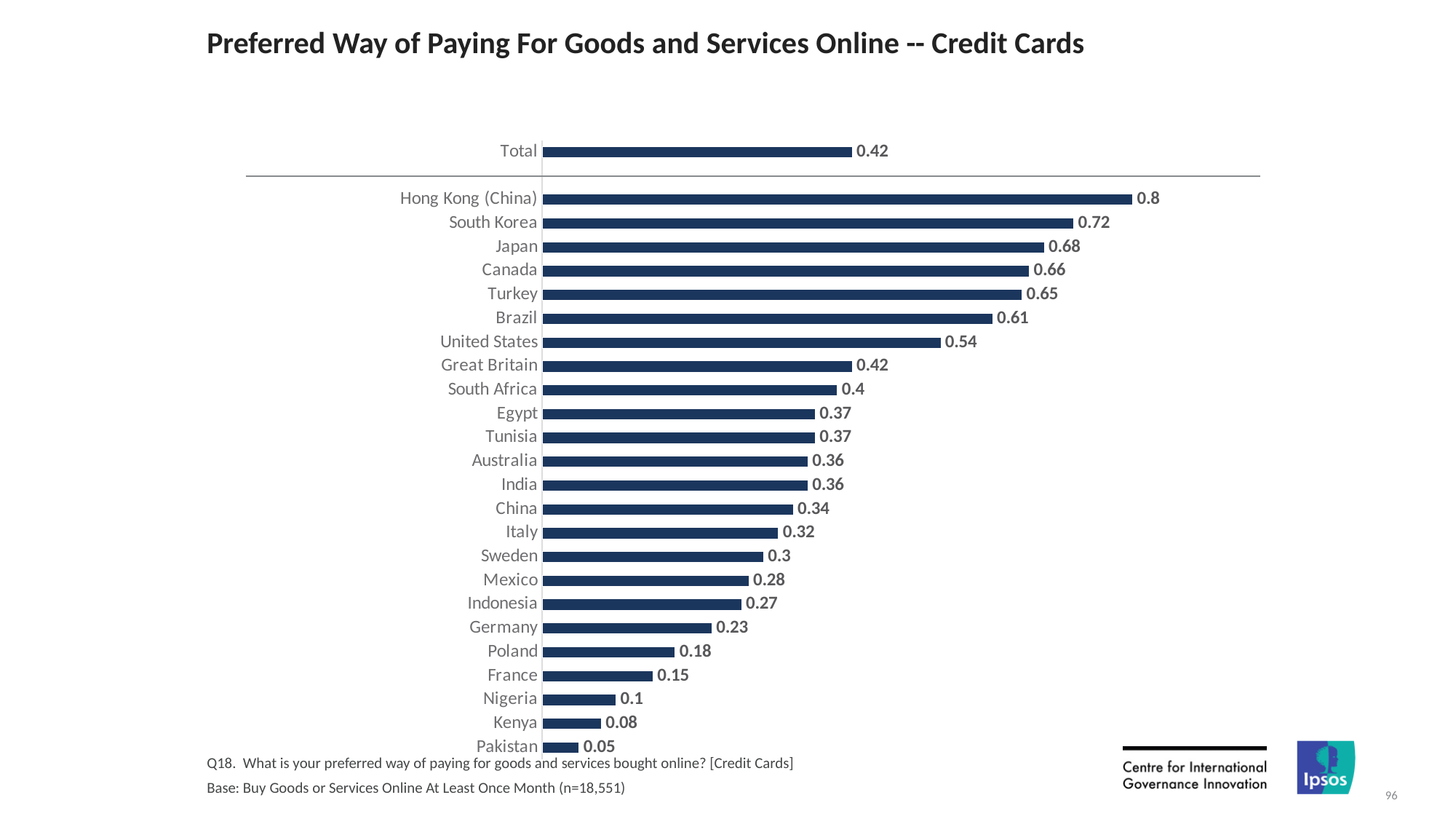
What is the difference between the values for United States and France? 0.39 What is the value for Hong Kong (China)? 0.8 What is the difference between the values for South Korea and Japan? 0.04 What is the value for Total? 0.42 What is the value for Brazil? 0.61 Which country has the lowest value? Pakistan How many countries are listed below the Total bar? 24 Which is larger, the value for Canada or the value for Turkey? Canada Which is larger, the value for Sweden or the value for Mexico? Sweden What is the value for Germany? 0.23 What kind of chart is shown on the slide? Bar chart Which country has the highest value? Hong Kong (China)